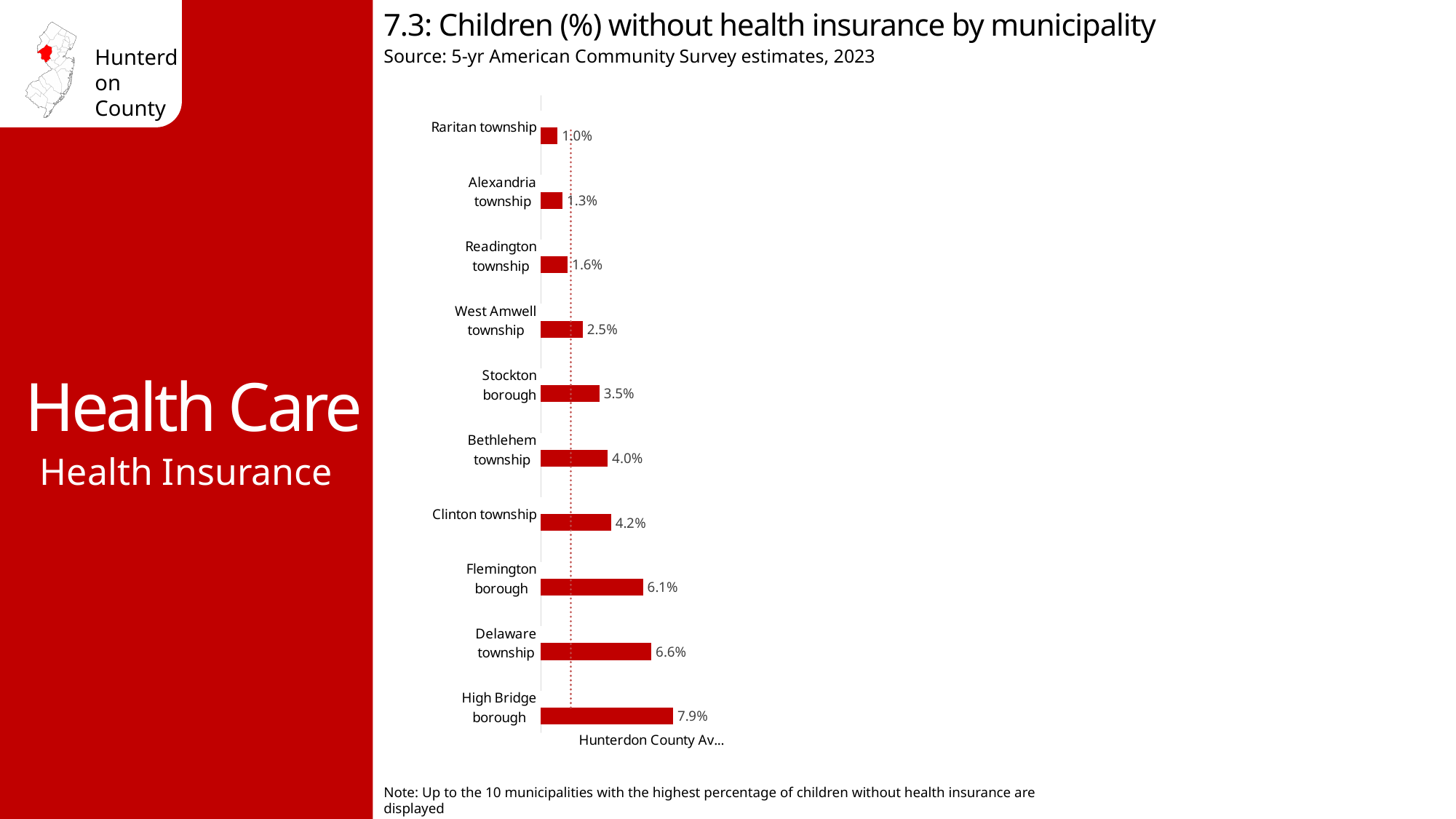
What percentage is shown for Clinton township? 4.2% What is the source of the data cited on the slide? 5-yr American Community Survey estimates, 2023 What is the difference between the values for High Bridge borough and Raritan township? 6.9% Which municipality has the lowest percentage of children without health insurance? Raritan township How many municipalities are shown in the chart? 10 What does the dotted vertical line on the chart represent? Hunterdon County Average What kind of chart is shown on the slide? Bar chart Which municipality has the highest percentage of children without health insurance? High Bridge borough What is the difference between the values for Delaware township and Flemington borough? 0.5% What is the value shown for Stockton borough? 3.5% Which has a higher value, Bethlehem township or West Amwell township? Bethlehem township What percentage of children are without health insurance in High Bridge borough? 7.9%